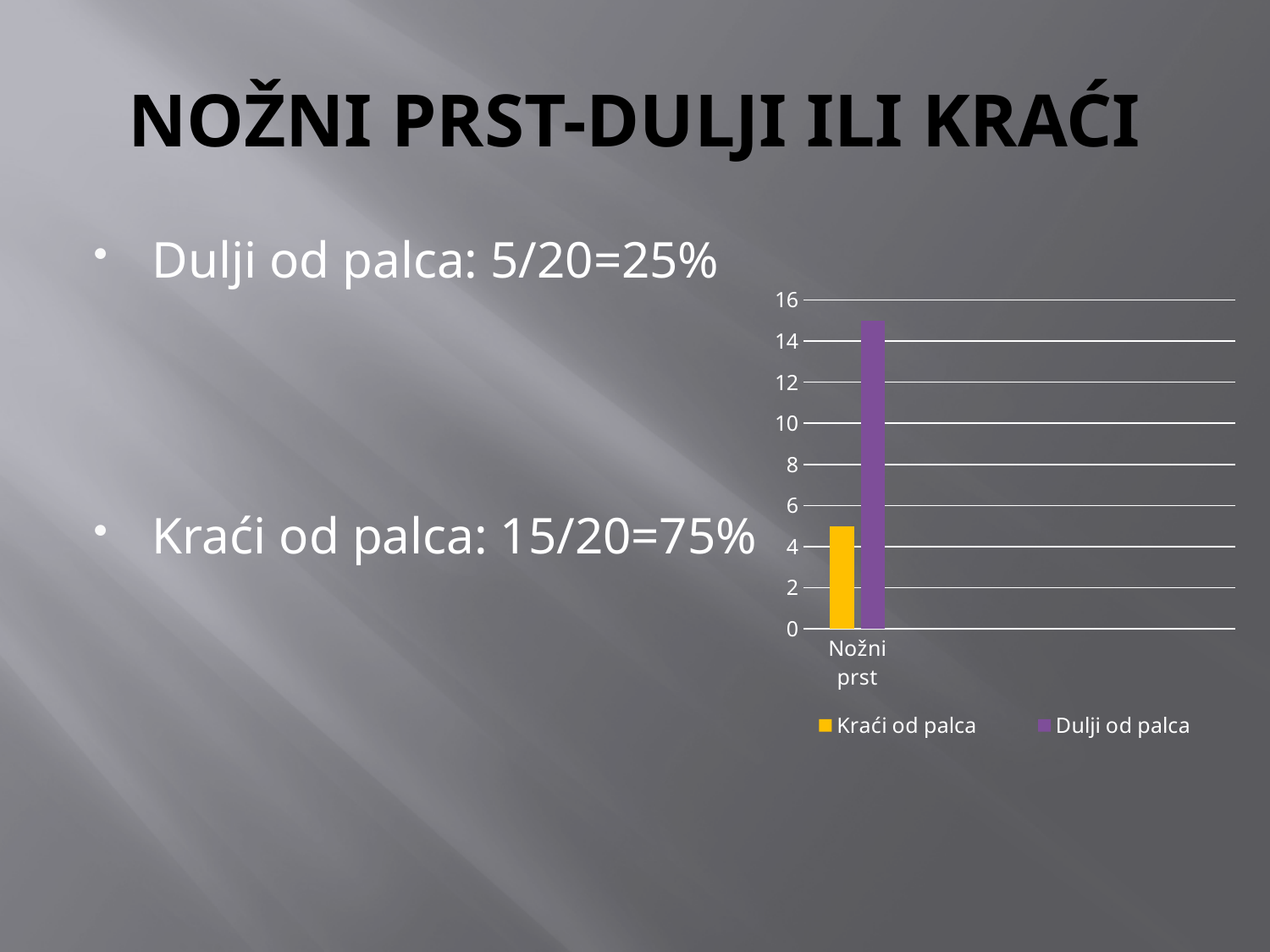
Is the value for Dulji od palca greater or less than 10? greater Which series has the tallest bar in the chart? Dulji od palca Is the value for Dulji od palca greater or less than 12? greater How many categories are shown on the x axis of the chart? 1 Which series has the shortest bar in the chart? Kraći od palca What kind of chart is shown on the slide? bar chart Is the value for Kraći od palca greater or less than 8? less Which series has the taller bar in the chart, Kraći od palca or Dulji od palca? Dulji od palca Which colour represents the series Dulji od palca in the chart legend? purple What is the label of the category on the x axis of the chart? Nožni prst How many series does the chart legend list? 2